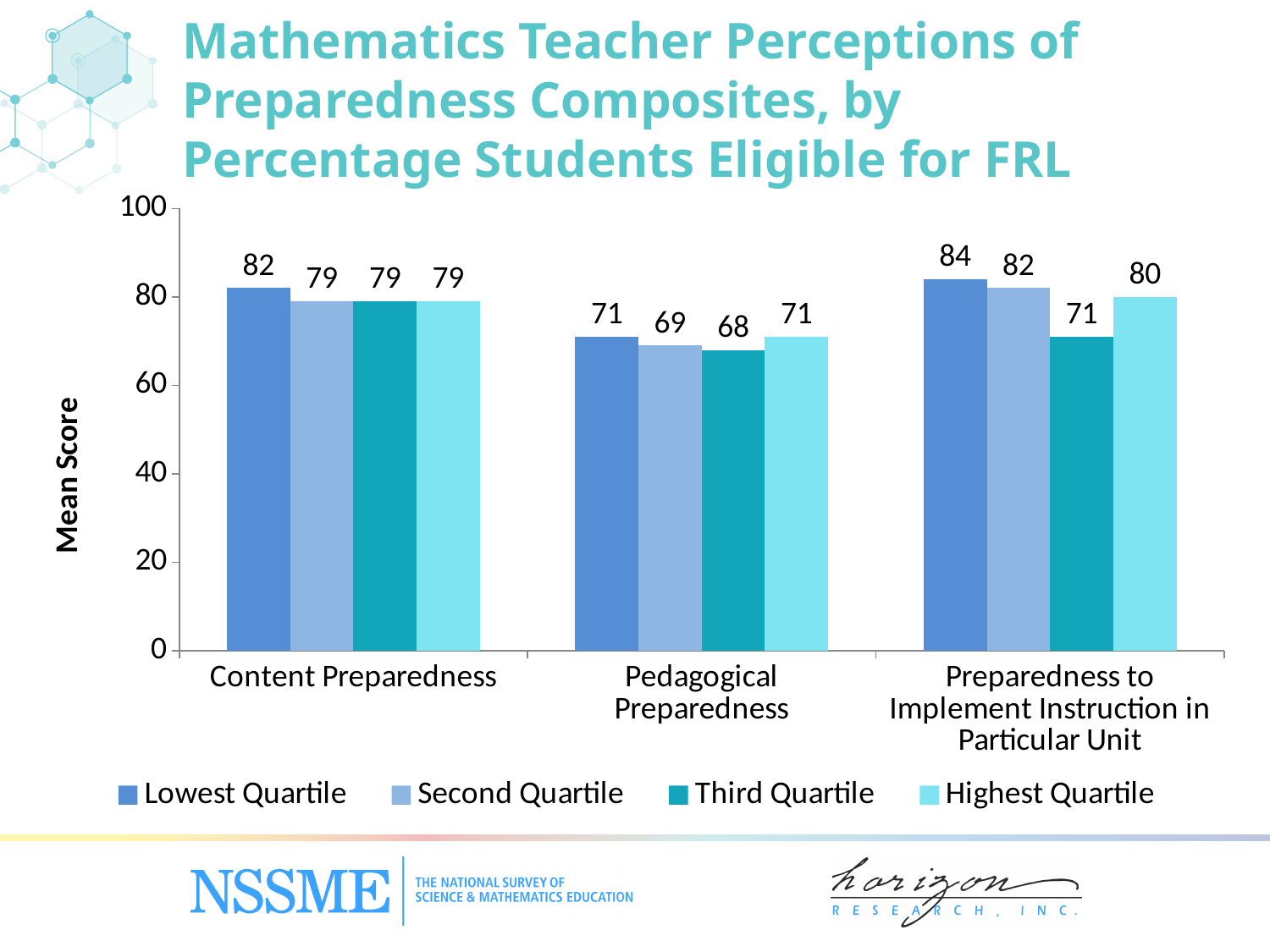
What is the label of the y axis? Mean Score How many series does the legend list? 4 Which quartile has the lowest mean score for Pedagogical Preparedness? Third Quartile How many composite categories are shown on the x axis? 3 Which quartile has the highest mean score for Preparedness to Implement Instruction in Particular Unit? Lowest Quartile What is the mean score for the Highest Quartile on Preparedness to Implement Instruction in Particular Unit? 80 What kind of chart is shown on the slide? bar chart Which is larger: the Second Quartile score for Content Preparedness or the Second Quartile score for Pedagogical Preparedness? Content Preparedness Is the Third Quartile mean score for Pedagogical Preparedness greater or less than 80? less What is the difference between the Lowest Quartile and Third Quartile mean scores for Preparedness to Implement Instruction in Particular Unit? 13 What is the mean score for the Third Quartile on Pedagogical Preparedness? 68 What is the mean score for the Lowest Quartile on Content Preparedness? 82